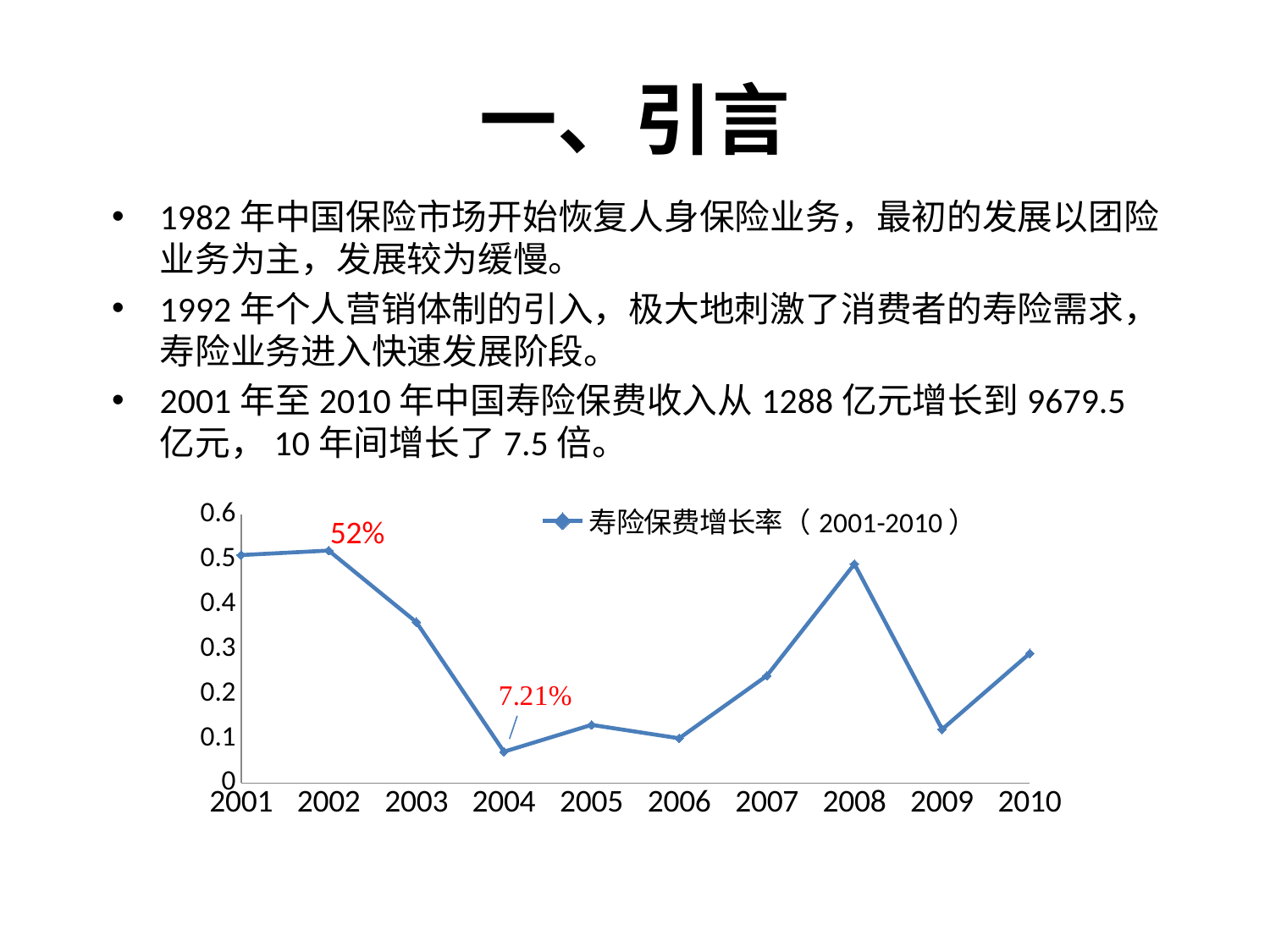
How many series does the chart's legend list? 1 How many years are plotted on the x axis of the chart? 10 What is the labelled value for 2004 in the line chart? 7.21% Which year has the larger value, 2007 or 2005? 2007 Is the value for 2008 greater or less than 0.4? greater Which year has the highest value in the line chart? 2002 What kind of chart is shown on the slide? line chart Is the value for 2009 greater or less than 0.2? less Do the values rise or fall from 2002 to 2004? fall What is the name of the series shown in the chart's legend? 寿险保费增长率（2001-2010） Which year has the lowest value in the line chart? 2004 What is the labelled value for 2002 in the line chart? 52%